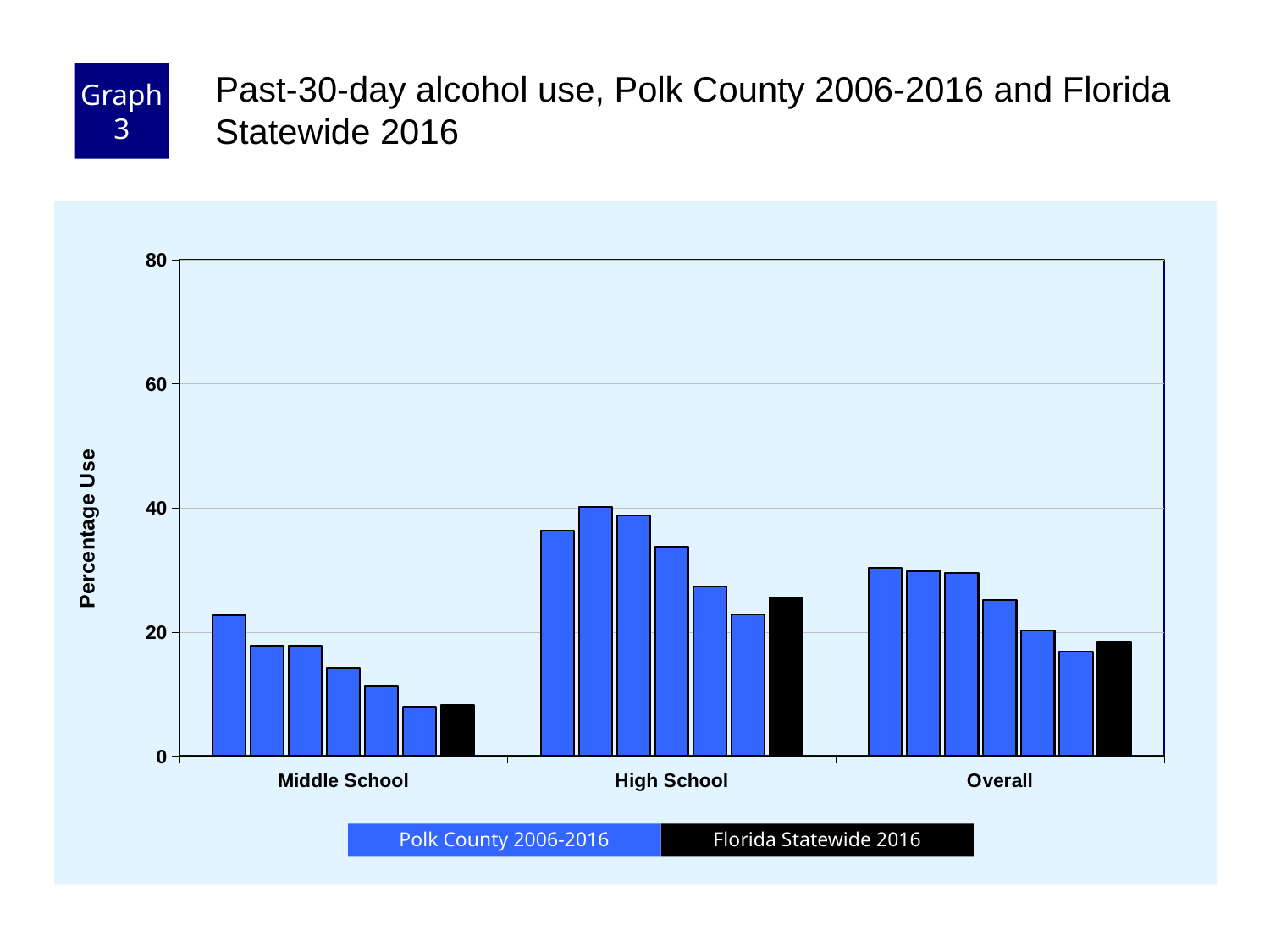
How many series does the legend list? 2 What is the label on the y axis? Percentage Use Is the Florida Statewide 2016 value for Middle School greater or less than 20? less Which category has the lowest Florida Statewide 2016 bar? Middle School Is the first (leftmost) Polk County bar for High School greater or less than 40? less Which category has the highest Florida Statewide 2016 bar? High School What kind of chart is shown on the slide? bar chart How many categories are shown on the x axis? 3 Is the first (leftmost) Polk County bar for Overall greater or less than 20? greater Do the Polk County 2006-2016 bars for Middle School rise or fall from left to right? fall Which is larger: the Florida Statewide 2016 bar for Overall or the Florida Statewide 2016 bar for High School? High School